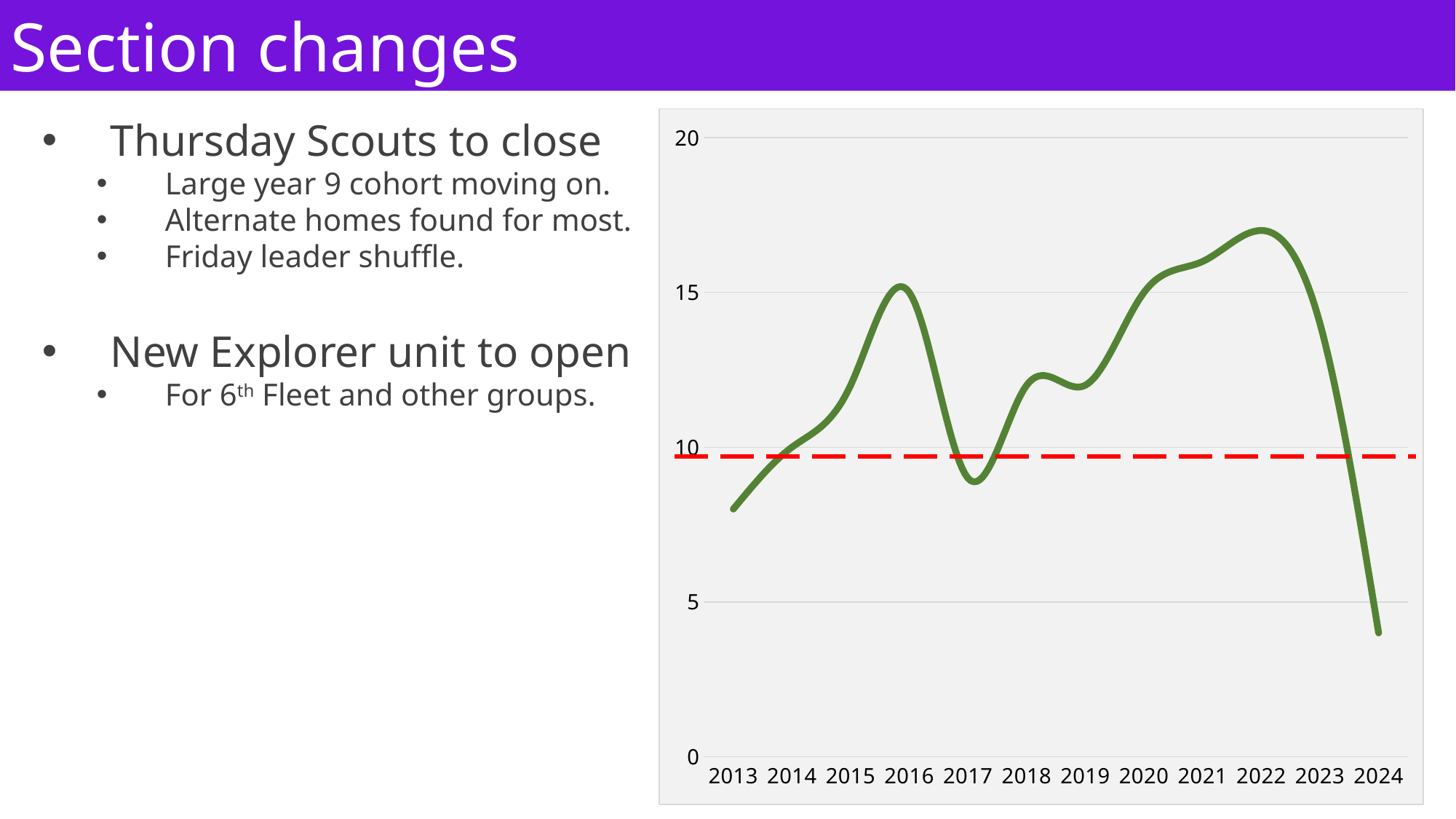
Which year has the larger value, 2016 or 2017? 2016 What colour is the dashed horizontal reference line on the chart? red Which year has the lowest value on the chart? 2024 How many years are plotted along the x axis of the chart? 12 Is the value for 2024 greater or less than 5? less Do the values rise or fall from 2022 to 2024? fall Which year has the highest value on the chart? 2022 Is the value for 2017 greater or less than 10? less Is the value for 2021 greater or less than 15? greater What kind of chart is shown on the slide? line chart